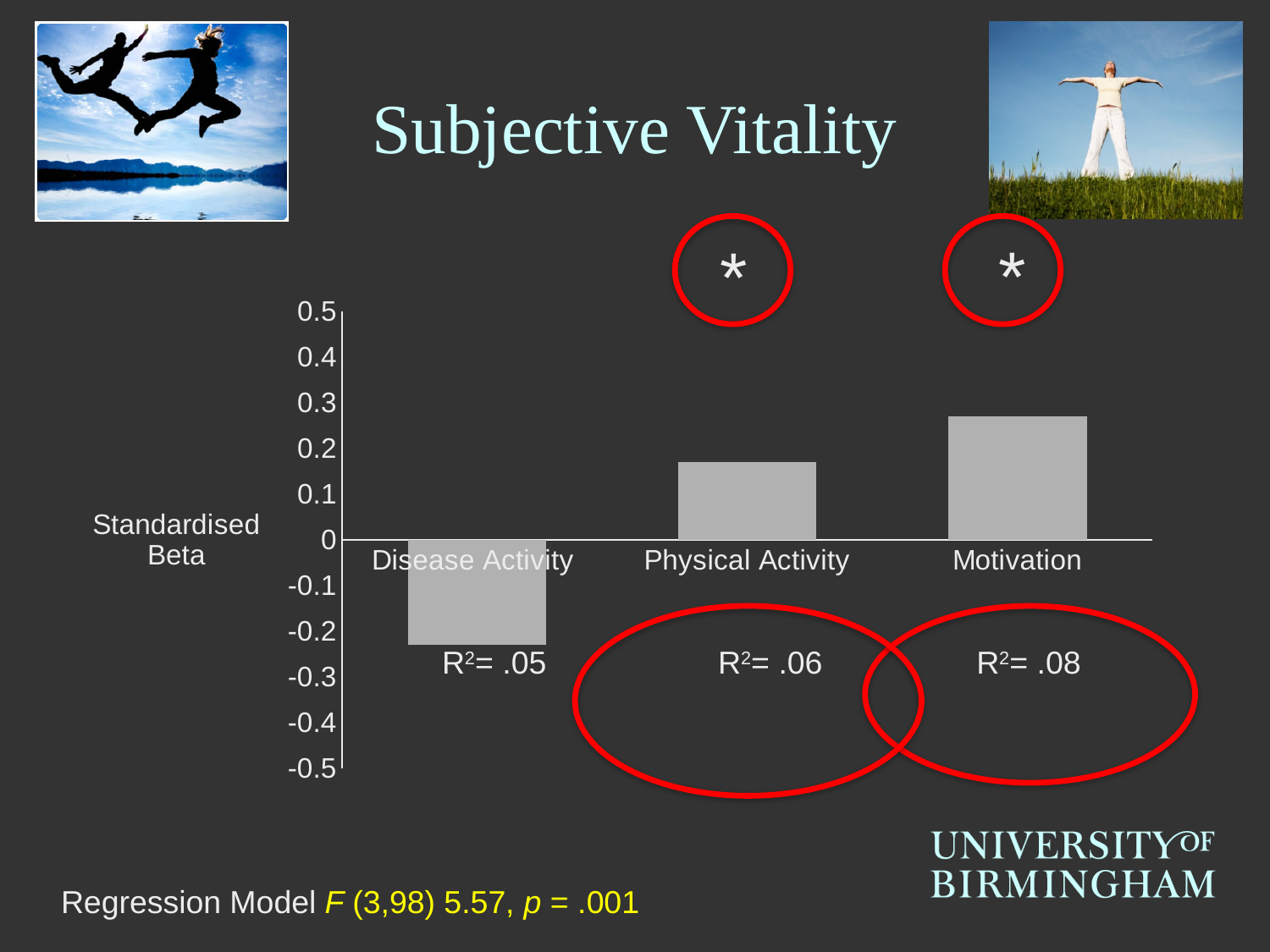
Which category has the highest standardised beta? Motivation Which category has the lowest standardised beta? Disease Activity How many categories are plotted on the chart? 3 Do the bar values rise or fall moving from Disease Activity to Motivation along the x axis? rise What is the title of the chart? Subjective Vitality What label is given to the vertical axis of the chart? Standardised Beta Is the standardised beta for Motivation greater or less than 0.2? greater Is the standardised beta for Disease Activity greater or less than -0.1? less Is the standardised beta for Motivation greater or less than 0.3? less What kind of chart is shown on the slide? bar chart Which is larger, the standardised beta for Motivation or for Physical Activity? Motivation